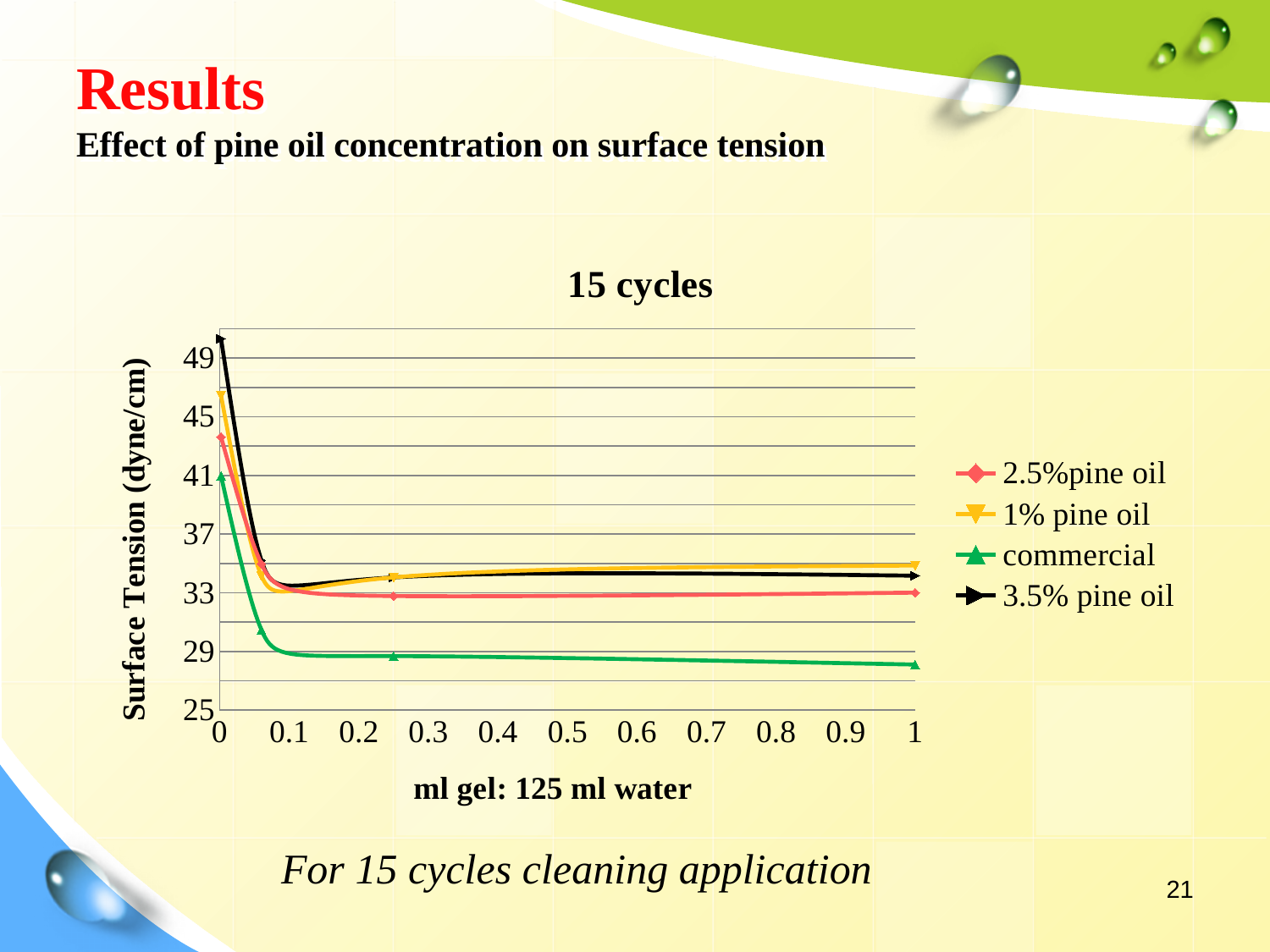
What is the label of the vertical axis? Surface Tension (dyne/cm) How many series does the legend list? 4 At 1 ml gel, which is higher: 1% pine oil or commercial? 1% pine oil Which series has the lowest surface tension at 0 ml gel? commercial Is the value for 1% pine oil at 0 ml gel greater or less than 45? greater Which series has the highest surface tension at 0 ml gel? 3.5% pine oil What is the title of the chart? 15 cycles Is the value for 3.5% pine oil at 0 ml gel greater or less than 49? greater Does the surface tension for the commercial series rise or fall from 0 to 1 ml gel? fall What kind of chart is shown on the slide? line chart Which series has the lowest surface tension at 1 ml gel? commercial Is the value for 2.5% pine oil at 1 ml gel greater or less than 37? less